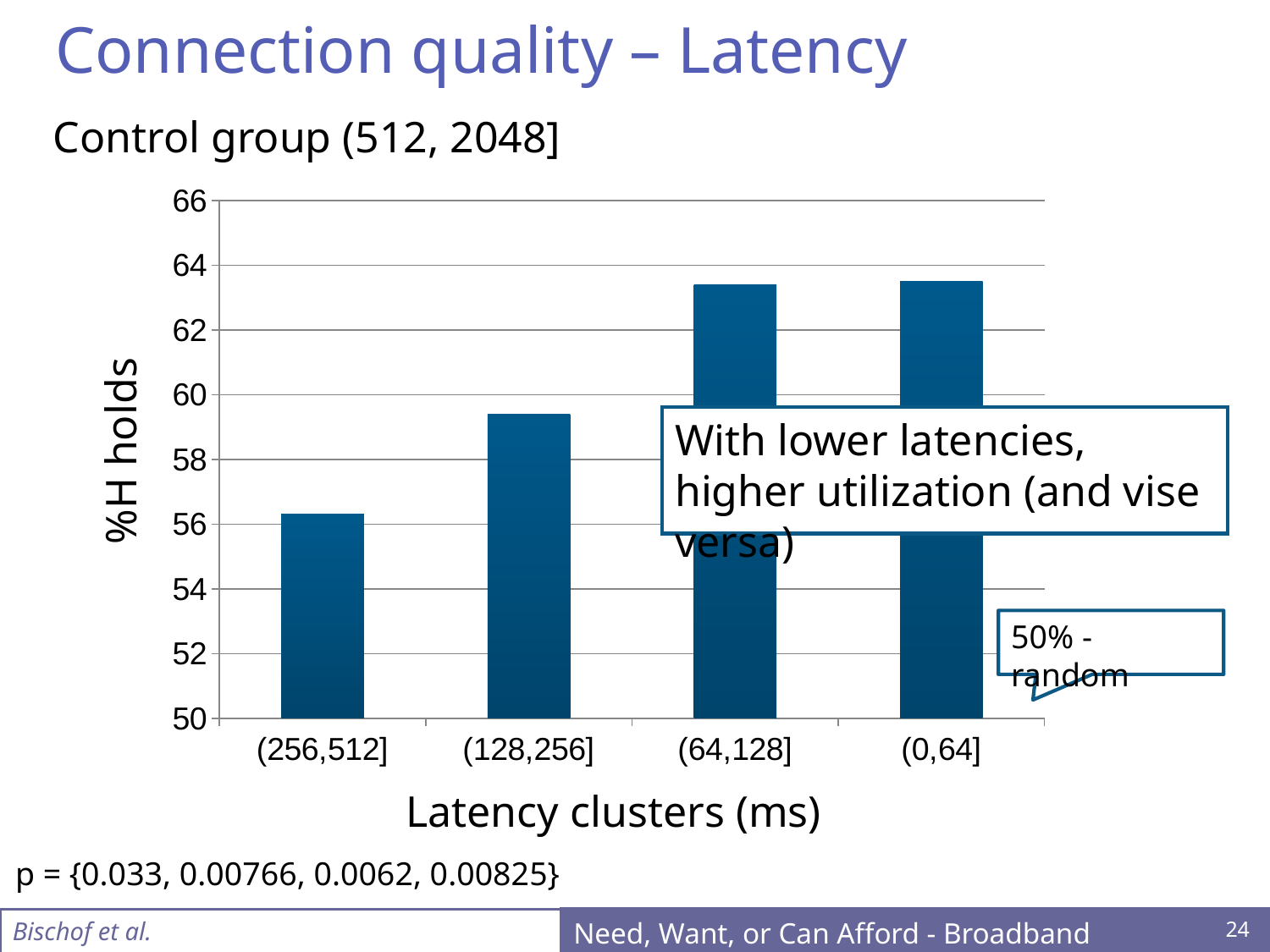
Is the value for (0,64] greater or less than 64? less Do the bar values rise or fall moving from (256,512] to (0,64] along the x axis? rise How many latency clusters are plotted on the x axis? 4 Which has a higher %H holds value, (128,256] or (256,512]? (128,256] What is the label of the y axis? %H holds Is the value for (128,256] greater or less than 60? less What kind of chart is shown on the slide? bar chart Is the value for (256,512] greater or less than 58? less Which latency cluster has the lowest %H holds value? (256,512] What is the label of the x axis? Latency clusters (ms)